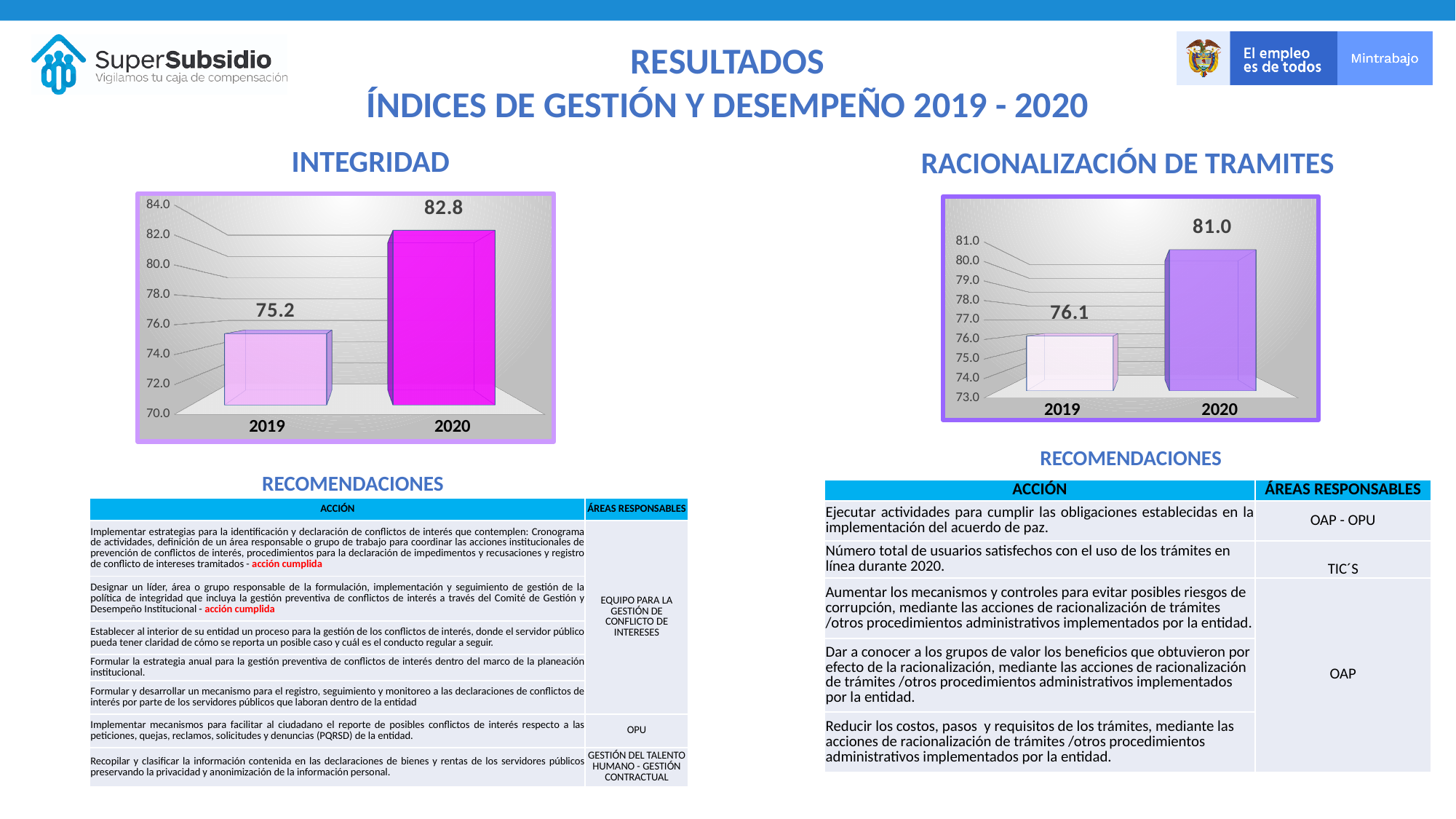
In the RACIONALIZACIÓN DE TRAMITES chart, what is the value for 2019? 76.1 In the INTEGRIDAD chart, is the value for 2019 greater or less than 76.0? less In the RACIONALIZACIÓN DE TRAMITES chart, what is the value for 2020? 81.0 In the RACIONALIZACIÓN DE TRAMITES chart, do the values rise or fall from 2019 to 2020? rise In the INTEGRIDAD chart, which year has the highest value? 2020 What kind of chart is the INTEGRIDAD chart? bar chart In the INTEGRIDAD chart, what is the value for 2019? 75.2 In the RACIONALIZACIÓN DE TRAMITES chart, which year has the lowest value? 2019 How many categories are shown in the RACIONALIZACIÓN DE TRAMITES chart? 2 In the INTEGRIDAD chart, what is the difference between the 2020 and 2019 values? 7.6 In the INTEGRIDAD chart, what is the value for 2020? 82.8 In the RACIONALIZACIÓN DE TRAMITES chart, what is the difference between the 2020 and 2019 values? 4.9